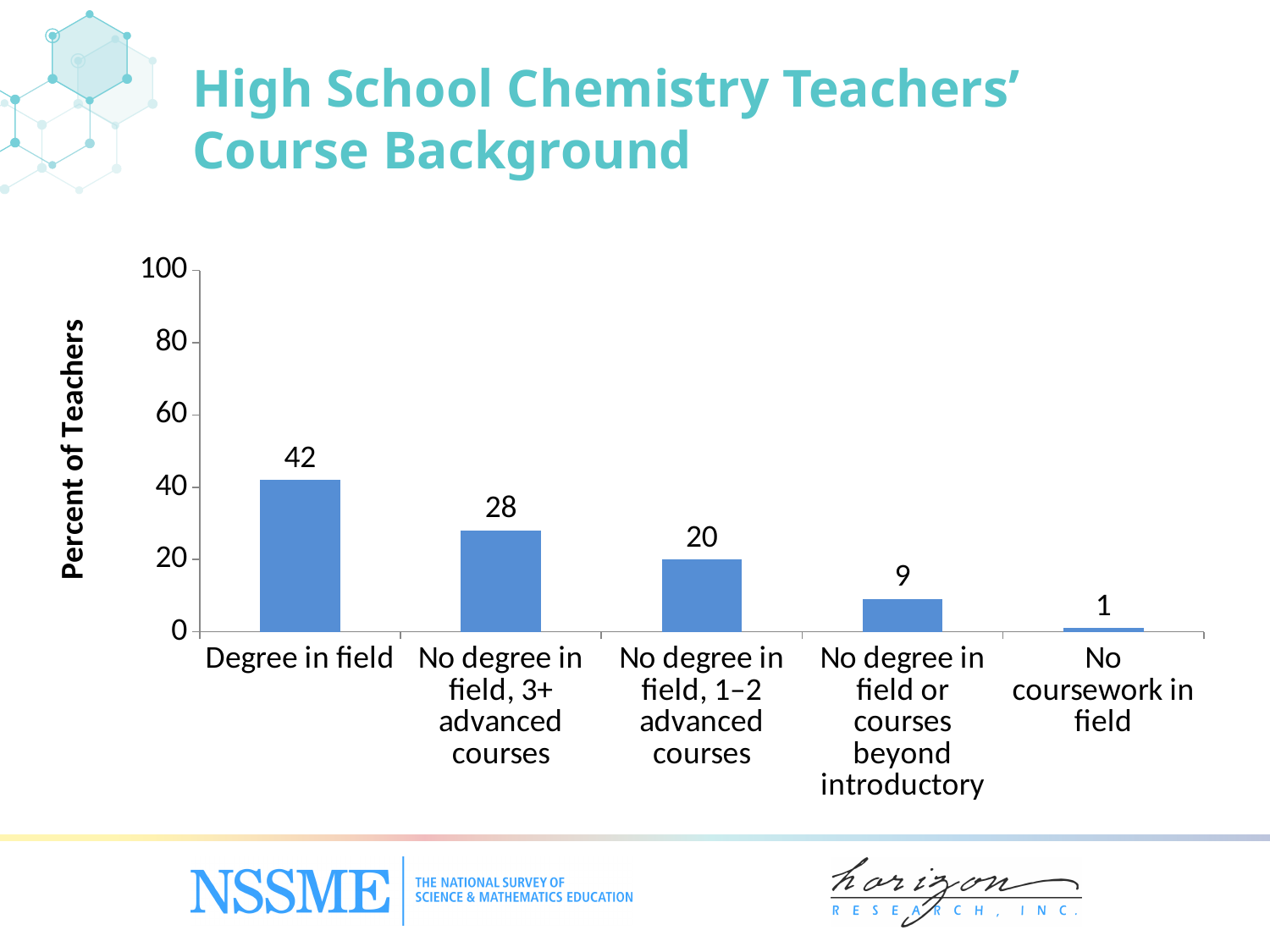
Which is larger: the value for 'No degree in field, 1–2 advanced courses' or 'No degree in field or courses beyond introductory'? No degree in field, 1–2 advanced courses What is the value for 'No degree in field, 3+ advanced courses'? 28 What is the value for 'No degree in field or courses beyond introductory'? 9 What percent of teachers have a degree in field? 42 What is the value for 'No degree in field, 1–2 advanced courses'? 20 Which category has the lowest percent of teachers? No coursework in field What is the label of the y axis? Percent of Teachers What kind of chart is shown on the slide? bar chart What is the difference between the values for 'Degree in field' and 'No degree in field, 3+ advanced courses'? 14 Which category has the highest percent of teachers? Degree in field Is the value for 'Degree in field' greater or less than 40? greater How many categories are shown on the x axis? 5